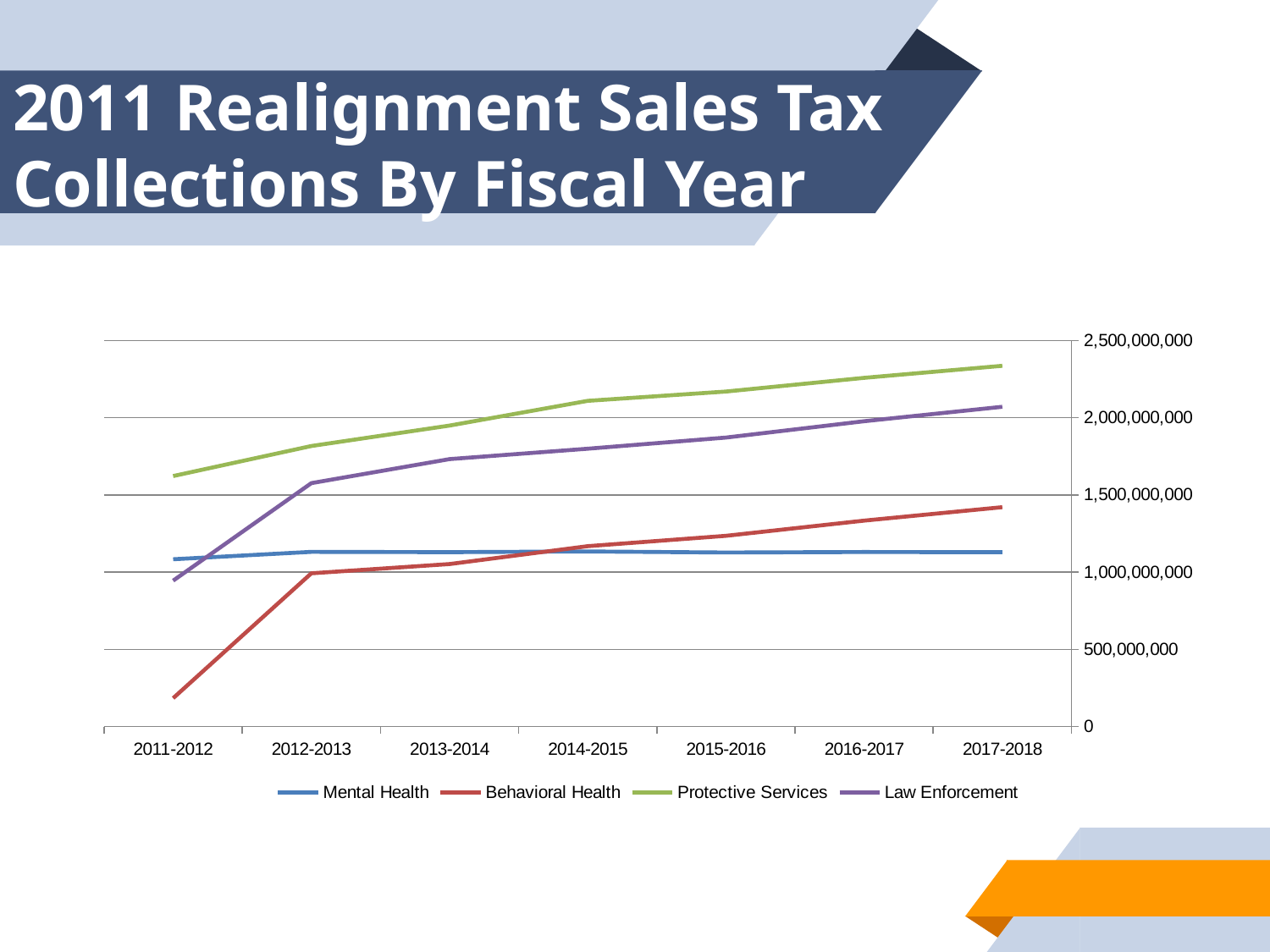
In 2014-2015, which is larger: Protective Services or Law Enforcement? Protective Services Is the value for Behavioral Health in 2017-2018 greater or less than 1,500,000,000? less Do the values for Protective Services rise or fall from 2011-2012 to 2017-2018? rise Which series has the highest value in 2017-2018? Protective Services What kind of chart is shown on the slide? Line chart How many fiscal years are plotted along the x axis? 7 Is the value for Protective Services in 2017-2018 greater or less than 2,000,000,000? greater Which series has the lowest value in 2011-2012? Behavioral Health Is the value for Behavioral Health in 2011-2012 greater or less than 500,000,000? less How many series does the legend list? 4 What is the title of the slide containing the chart? 2011 Realignment Sales Tax Collections By Fiscal Year